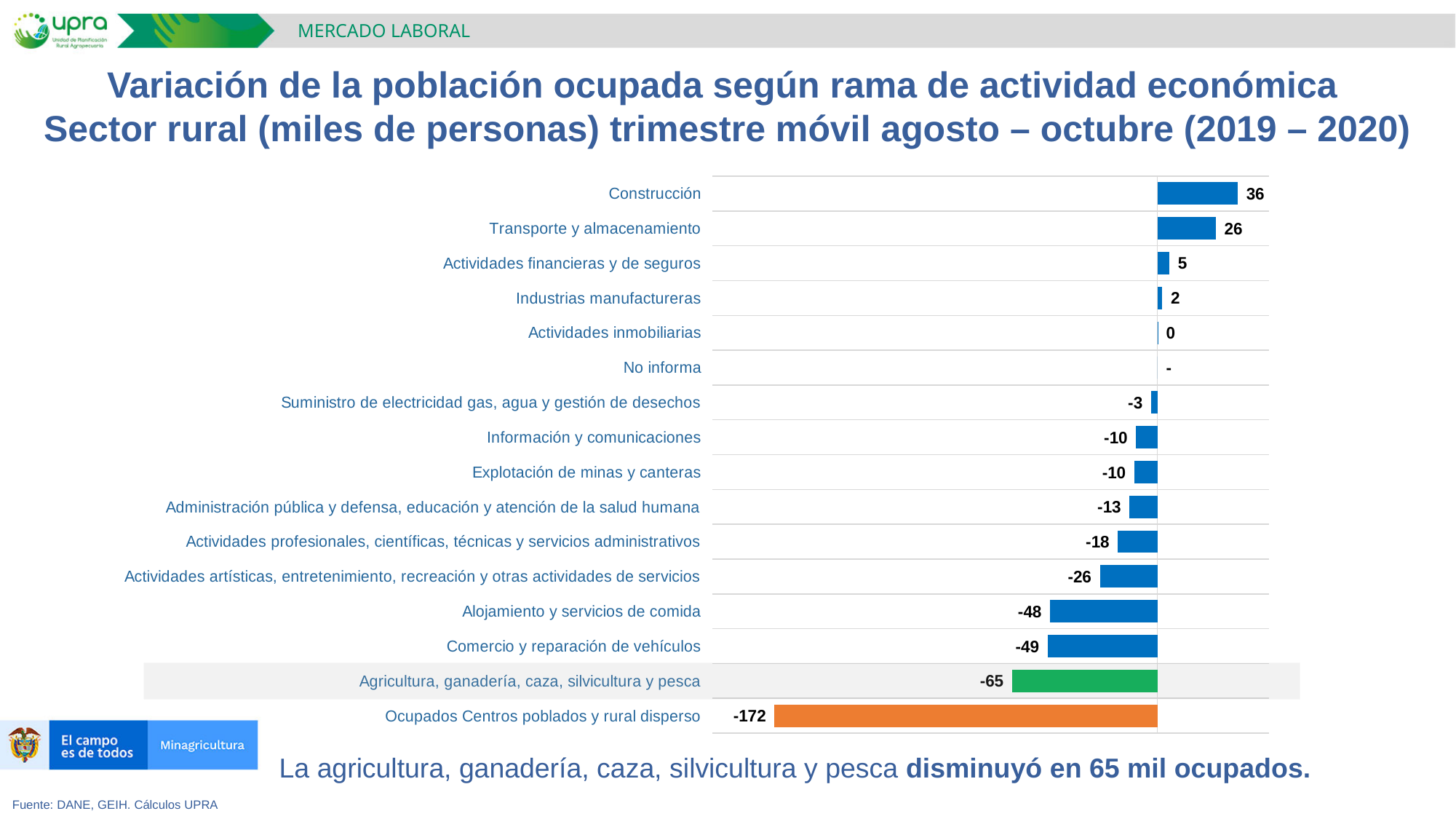
Which category has the highest value? Construcción What is the value for Ocupados Centros poblados y rural disperso? -172 What is the difference between the values for Construcción and Transporte y almacenamiento? 10 What colour is the bar for Agricultura, ganadería, caza, silvicultura y pesca? Green What kind of chart is shown on the slide? Bar chart Which is larger, the value for Transporte y almacenamiento or the value for Actividades financieras y de seguros? Transporte y almacenamiento What is the value for Agricultura, ganadería, caza, silvicultura y pesca? -65 What is the value for Actividades inmobiliarias? 0 What is the value for Alojamiento y servicios de comida? -48 What is the value for Construcción? 36 How many categories are shown in the chart? 16 Which category has the lowest value? Ocupados Centros poblados y rural disperso